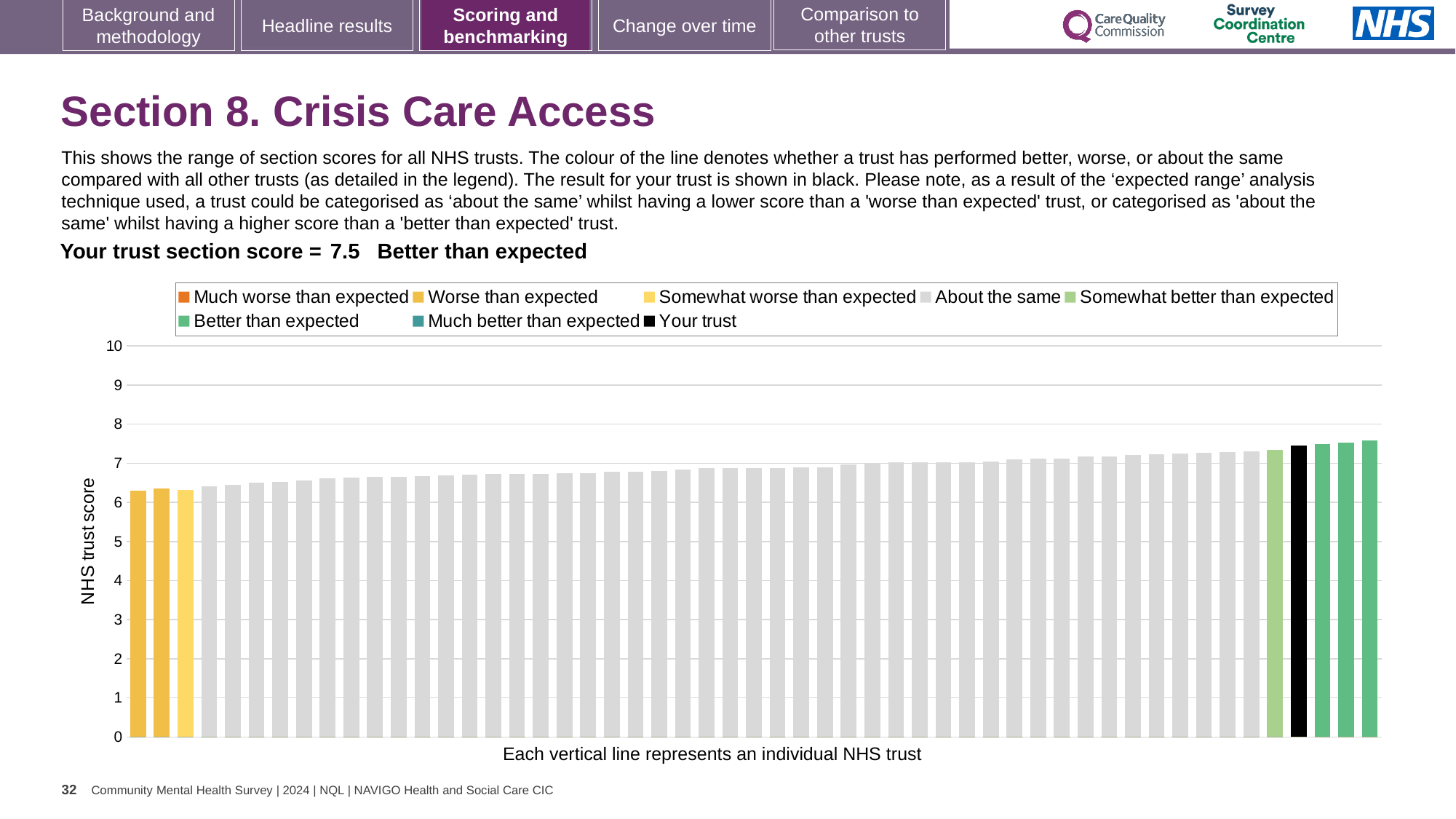
What kind of chart is shown on the slide? bar chart Which performance category is your trust placed in for Crisis Care Access? Better than expected Do the bar values rise or fall from left to right along the x axis? rise What is the section score for your trust? 7.5 How many entries does the chart legend list? 8 Is the value of the lowest bar in the chart greater or less than 6? greater How many bars are coloured as 'Worse than expected'? 2 What is the label on the vertical axis of the chart? NHS trust score Which is larger: the value for your trust or the value of the leftmost bar? your trust Is the value of the highest bar in the chart greater or less than 8? less Is the value for your trust greater or less than 7? greater How many bars are coloured as 'Better than expected'? 3